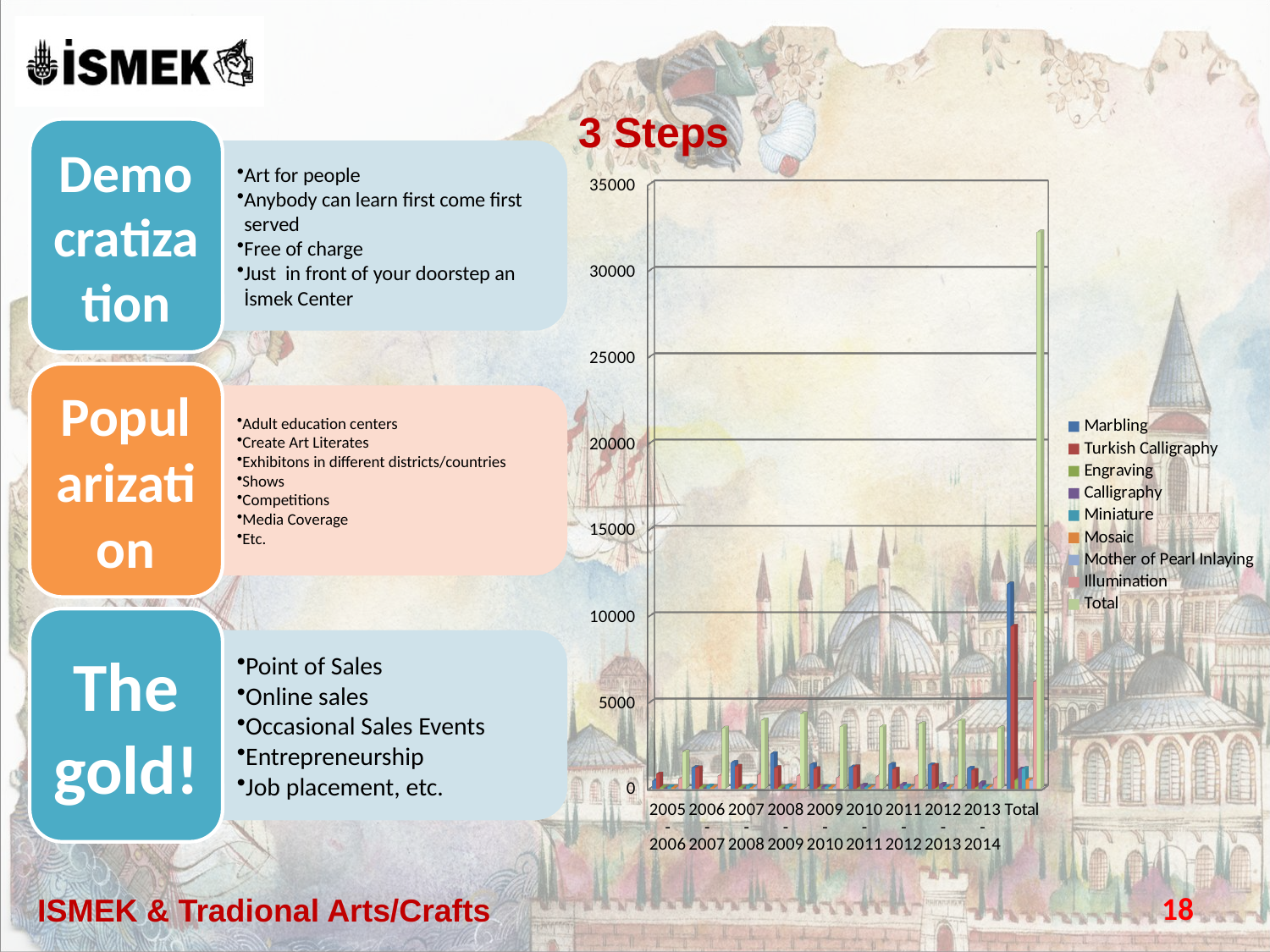
How many categories are shown along the x axis of the chart? 10 Is the value of the Total series for 2013-2014 greater or less than 5000? less Is the value of the Total series for 2005-2006 greater or less than 5000? less How many series does the chart legend list? 9 Is the value of the Total series for the Total category greater or less than 30000? greater What is the first entry listed in the chart legend? Marbling What kind of chart is shown on the slide? bar chart Which category has the tallest bar in the chart? Total What is the last entry listed in the chart legend? Total In the Total category, which is larger: the Marbling bar or the Turkish Calligraphy bar? Marbling